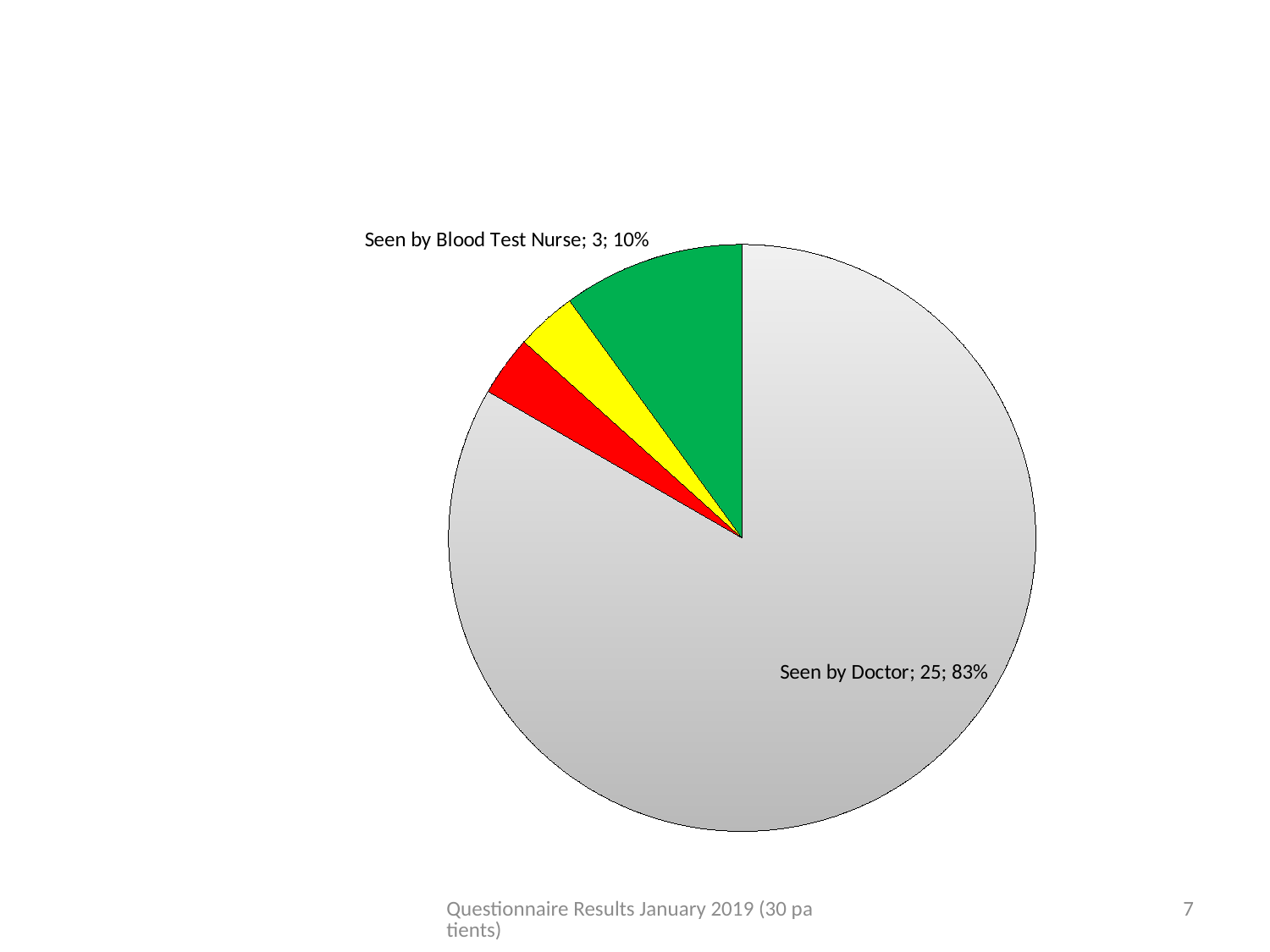
What colour is the Seen by Doctor slice? grey What percentage of the pie is the Seen by Doctor slice? 83% Which is larger: the Seen by Doctor slice or the Seen by Blood Test Nurse slice? Seen by Doctor How many slices does the pie chart have? 4 How many patients were Seen by Blood Test Nurse? 3 How many patients were Seen by Doctor? 25 What colour is the Seen by Blood Test Nurse slice? green Which category has the largest slice of the pie? Seen by Doctor What type of chart is shown on the slide? pie chart What is the difference between the number of patients Seen by Doctor and the number Seen by Blood Test Nurse? 22 What share of the pie does the Seen by Blood Test Nurse slice represent? 10%